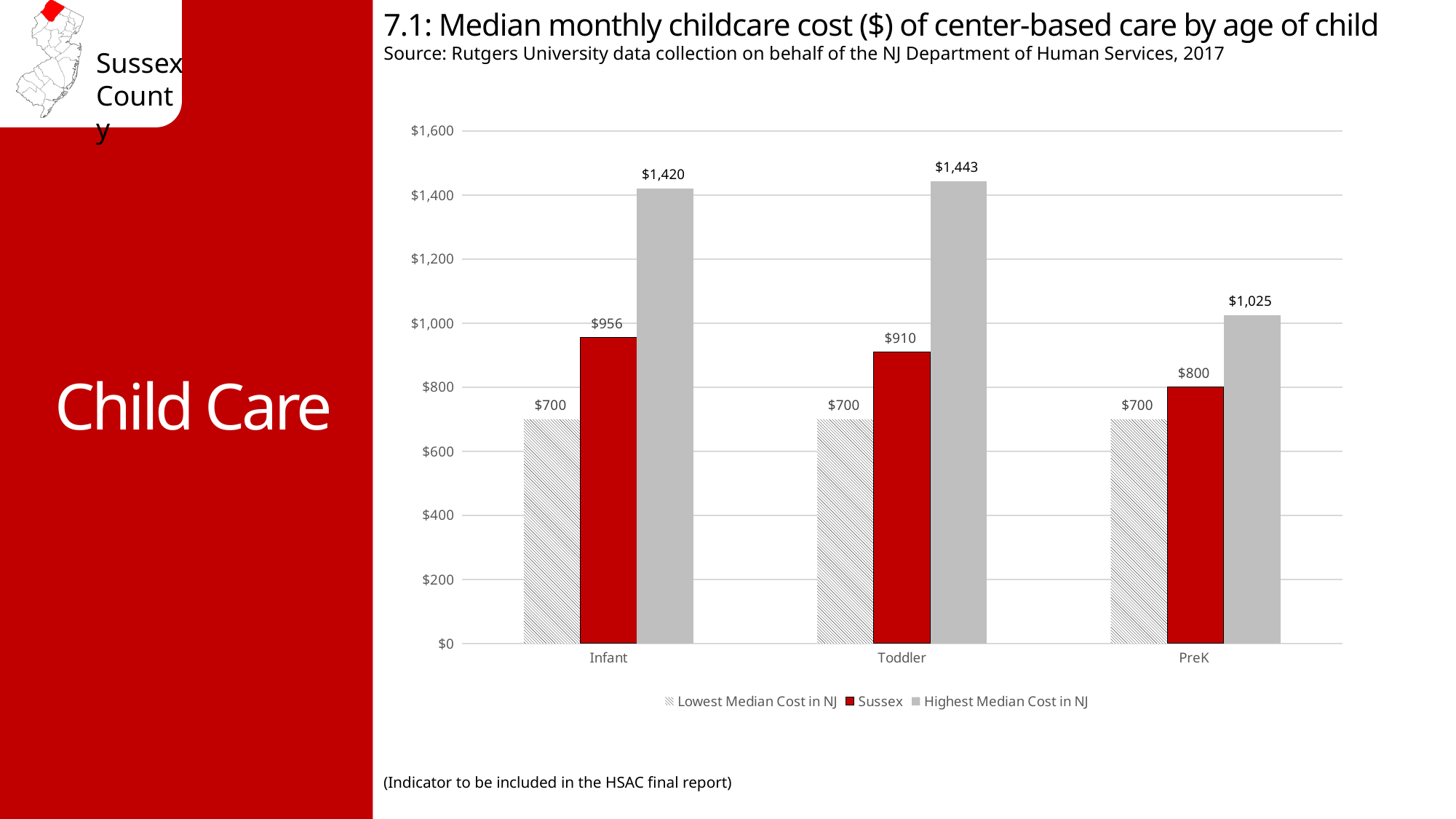
Is the Sussex value for PreK care greater or less than $1,000? less How many age groups are shown on the x axis? 3 What kind of chart is shown on the slide? bar chart What is the difference between the Highest Median Cost in NJ and the Sussex cost for Infant care? $464 What is the Lowest Median Cost in NJ for PreK care? $700 What is the Highest Median Cost in NJ for Toddler care? $1,443 Which age group has the highest Sussex median monthly cost? Infant Which age group has the lowest Highest Median Cost in NJ? PreK What is the Sussex median monthly childcare cost for Infant care? $956 Which is larger: the Sussex cost for Toddler care or the Sussex cost for PreK care? Toddler Which series is drawn in red? Sussex How many series does the legend list? 3